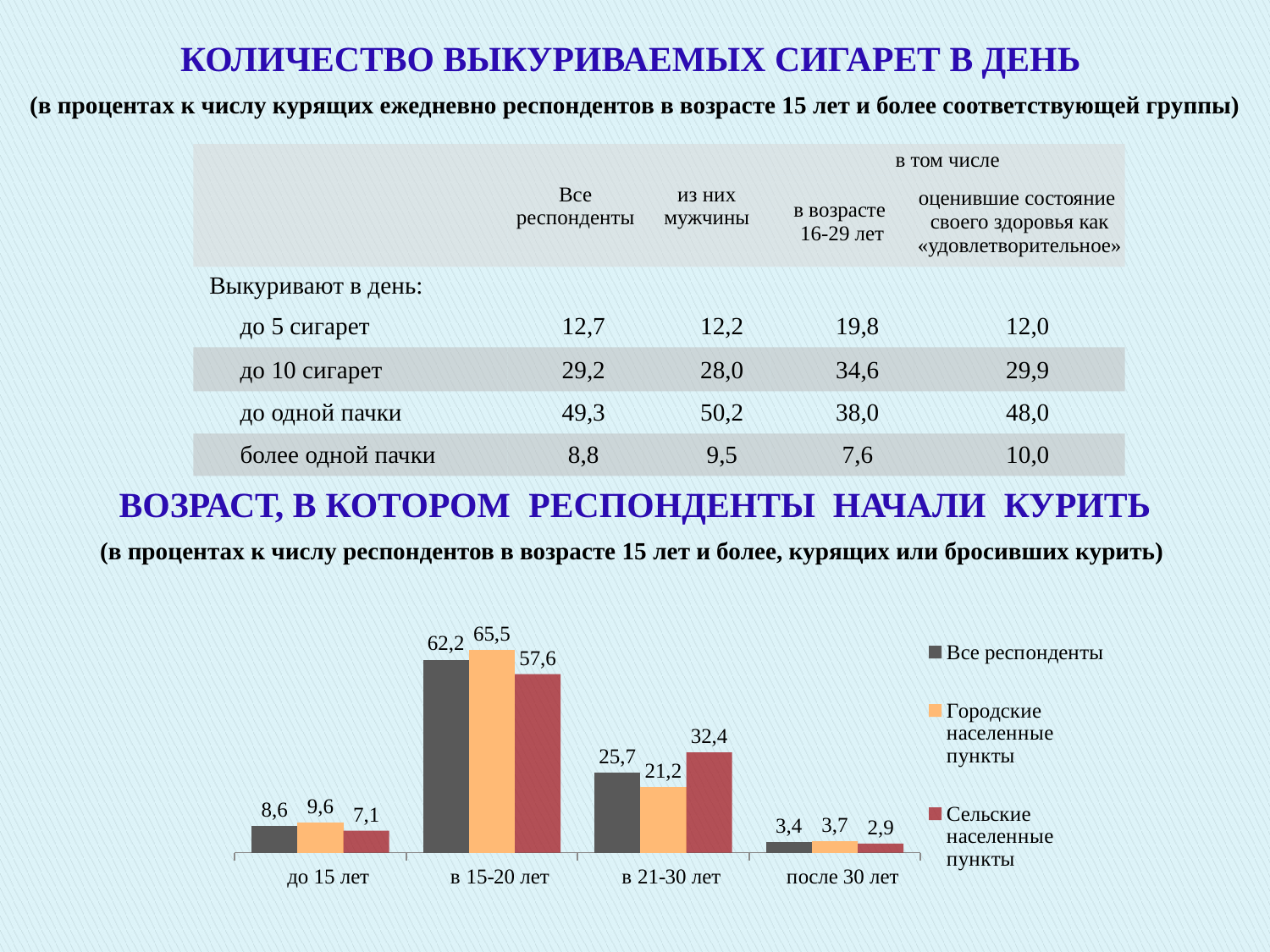
What is the difference between 'Городские населенные пункты' and 'Сельские населенные пункты' in the 'в 15-20 лет' category? 7,9 Which series in the chart is shown in orange? Городские населенные пункты What type of chart is shown on the slide? Bar chart In the 'в 21-30 лет' category, which is larger: 'Все респонденты' or 'Городские населенные пункты'? Все респонденты How many age categories are shown on the x axis of the chart? 4 What is the difference between 'Сельские населенные пункты' and 'Городские населенные пункты' in the 'в 21-30 лет' category? 11,2 What is the value for 'Городские населенные пункты' in the 'до 15 лет' category? 9,6 Which age category has the lowest value for 'Сельские населенные пункты'? после 30 лет Which age category has the highest value for 'Все респонденты'? в 15-20 лет What is the value for 'Сельские населенные пункты' in the 'в 21-30 лет' category? 32,4 How many series does the chart legend list? 3 What is the value for 'Все респонденты' in the 'в 15-20 лет' category? 62,2